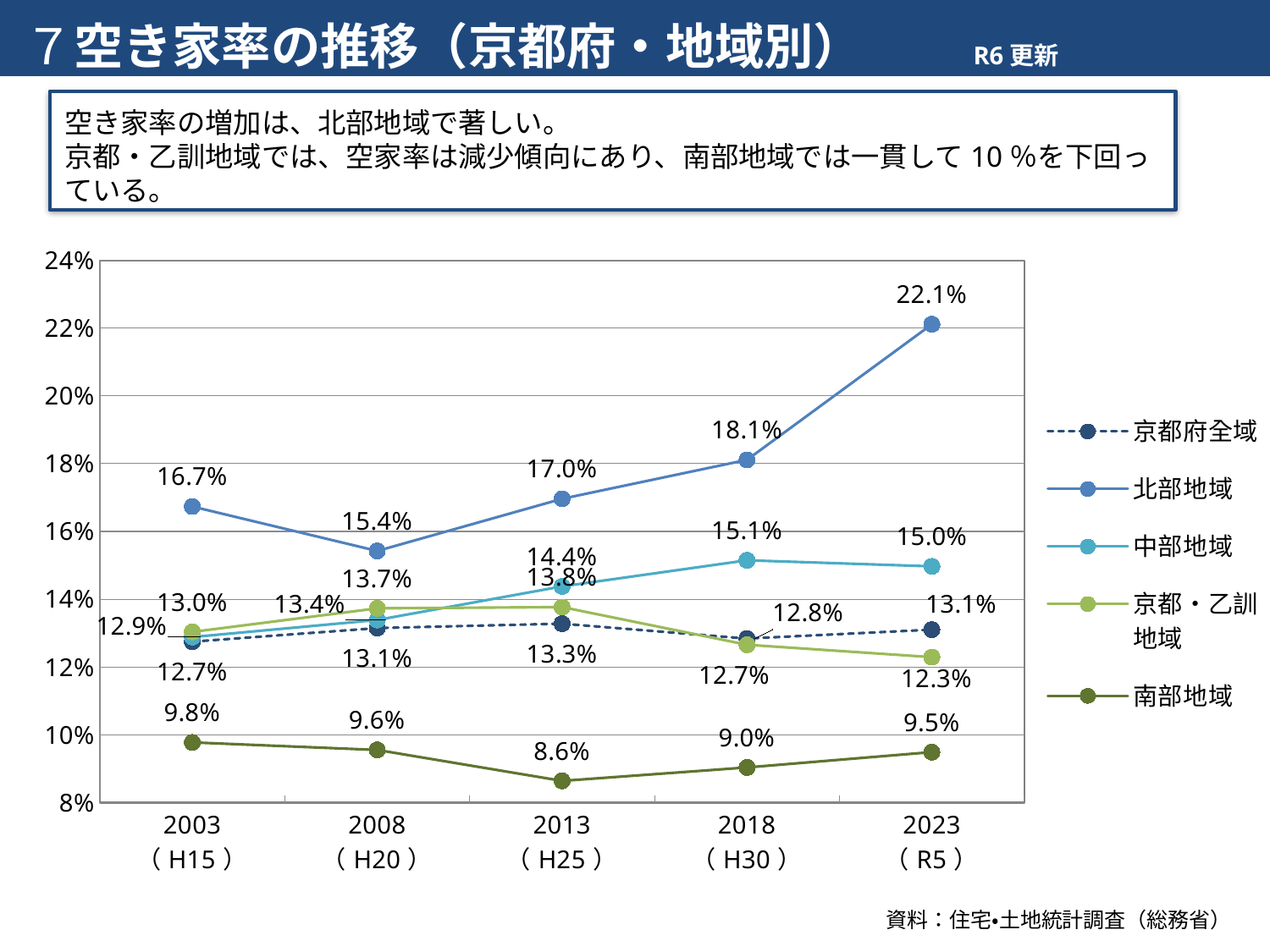
Which region has the highest vacancy rate in 2023 (R5)? 北部地域 How many survey years are plotted along the x axis? 5 What is the vacancy rate for 中部地域 in 2018 (H30)? 15.1% What is the vacancy rate for 北部地域 in 2023 (R5)? 22.1% What is the difference between the 北部地域 vacancy rate in 2023 and in 2003? 5.4% What is the vacancy rate for 南部地域 in 2013 (H25)? 8.6% Does the vacancy rate for 北部地域 rise or fall from 2008 to 2023? rise Which region has the lowest vacancy rate in 2018 (H30)? 南部地域 How many series does the legend list? 5 What type of chart is shown on the slide? line chart Is the vacancy rate for 南部地域 in 2023 greater or less than 10%? less What is the vacancy rate for 京都・乙訓地域 in 2023 (R5)? 12.3%